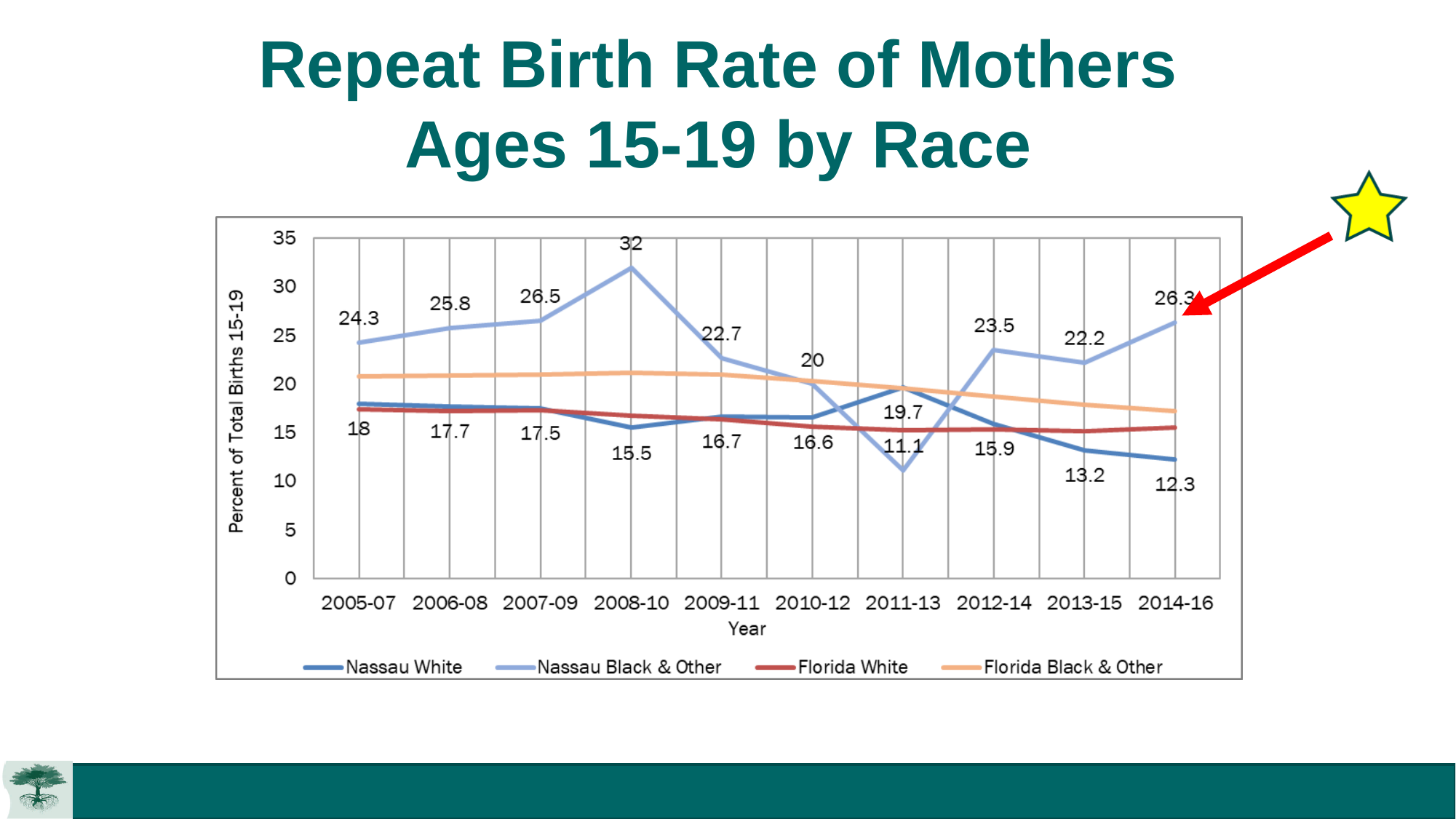
How many year periods are shown on the x axis? 10 In which year period does Nassau Black & Other reach its highest value? 2008-10 Is the value for Florida Black & Other in 2005-07 greater or less than 20? greater Which is larger in 2011-13, Nassau White or Nassau Black & Other? Nassau White How many series does the legend list? 4 What type of chart is shown on the slide? line chart What is the value for Nassau Black & Other in 2008-10? 32 What is the value for Nassau White in 2014-16? 12.3 What is the difference between the Nassau Black & Other value and the Nassau White value in 2014-16? 14 What is the label of the y axis? Percent of Total Births 15-19 In which year period is the Nassau White value lowest? 2014-16 What is the value for Nassau Black & Other in 2011-13? 11.1